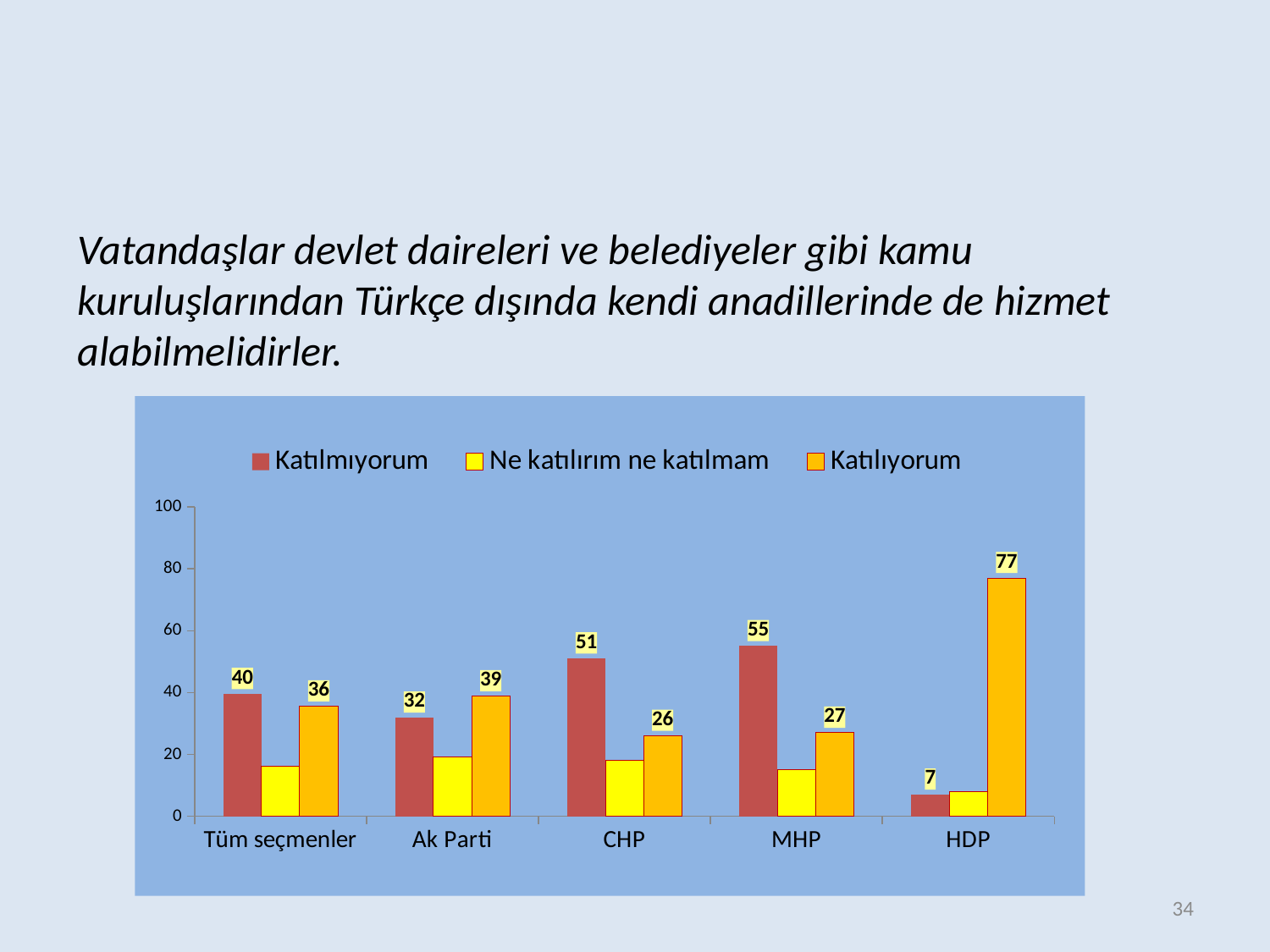
Which category has the highest Katılıyorum value? HDP How many categories are shown on the x axis? 5 For Ak Parti, which is larger: Katılmıyorum or Katılıyorum? Katılıyorum What kind of chart is shown on the slide? bar chart Which colour represents the Katılıyorum series? orange Which category has the lowest Katılmıyorum value? HDP Is the Ne katılırım ne katılmam value for Ak Parti greater or less than 40? less What is the difference between the Katılmıyorum and Katılıyorum values for CHP? 25 What is the Katılmıyorum value for Tüm seçmenler? 40 What is the Katılmıyorum value for MHP? 55 How many series does the legend list? 3 What is the Katılıyorum value for HDP? 77